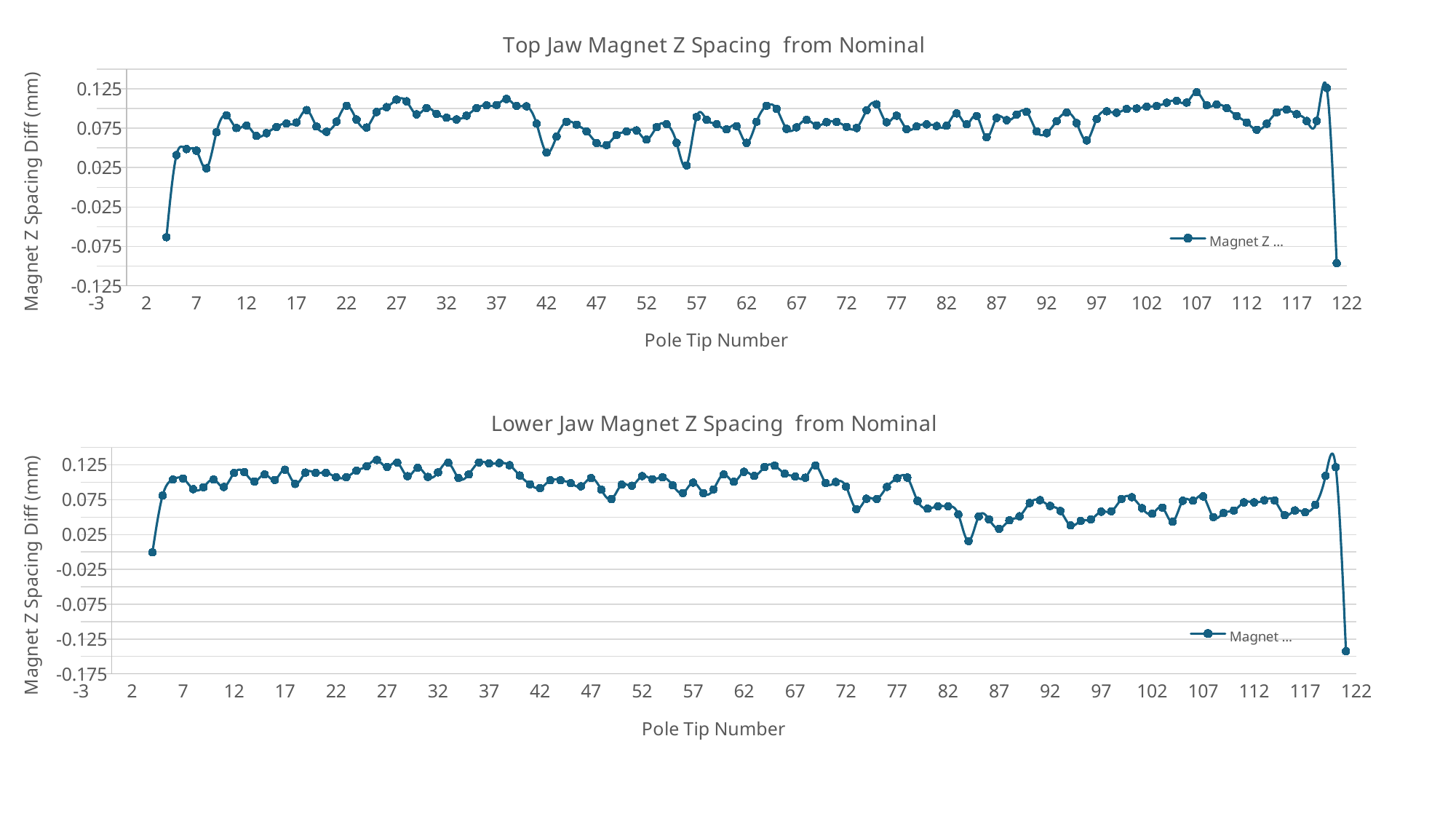
How many series does the legend of the "Top Jaw Magnet Z Spacing from Nominal" chart list? 1 In the "Lower Jaw Magnet Z Spacing from Nominal" chart, is the value at pole tip 84 greater or less than 0.025? less What kind of chart is the "Top Jaw Magnet Z Spacing from Nominal" chart? line chart In the "Lower Jaw Magnet Z Spacing from Nominal" chart, which is larger: the value at pole tip 37 or the value at pole tip 87? pole tip 37 In the "Top Jaw Magnet Z Spacing from Nominal" chart, is the value at the first plotted pole tip (around 4) greater or less than -0.025? less In the "Lower Jaw Magnet Z Spacing from Nominal" chart, is the value at the last pole tip (around 121) greater or less than -0.125? less What is the y-axis title of the "Top Jaw Magnet Z Spacing from Nominal" chart? Magnet Z Spacing Diff (mm) What kind of chart is the "Lower Jaw Magnet Z Spacing from Nominal" chart? line chart What is the x-axis title of the "Lower Jaw Magnet Z Spacing from Nominal" chart? Pole Tip Number